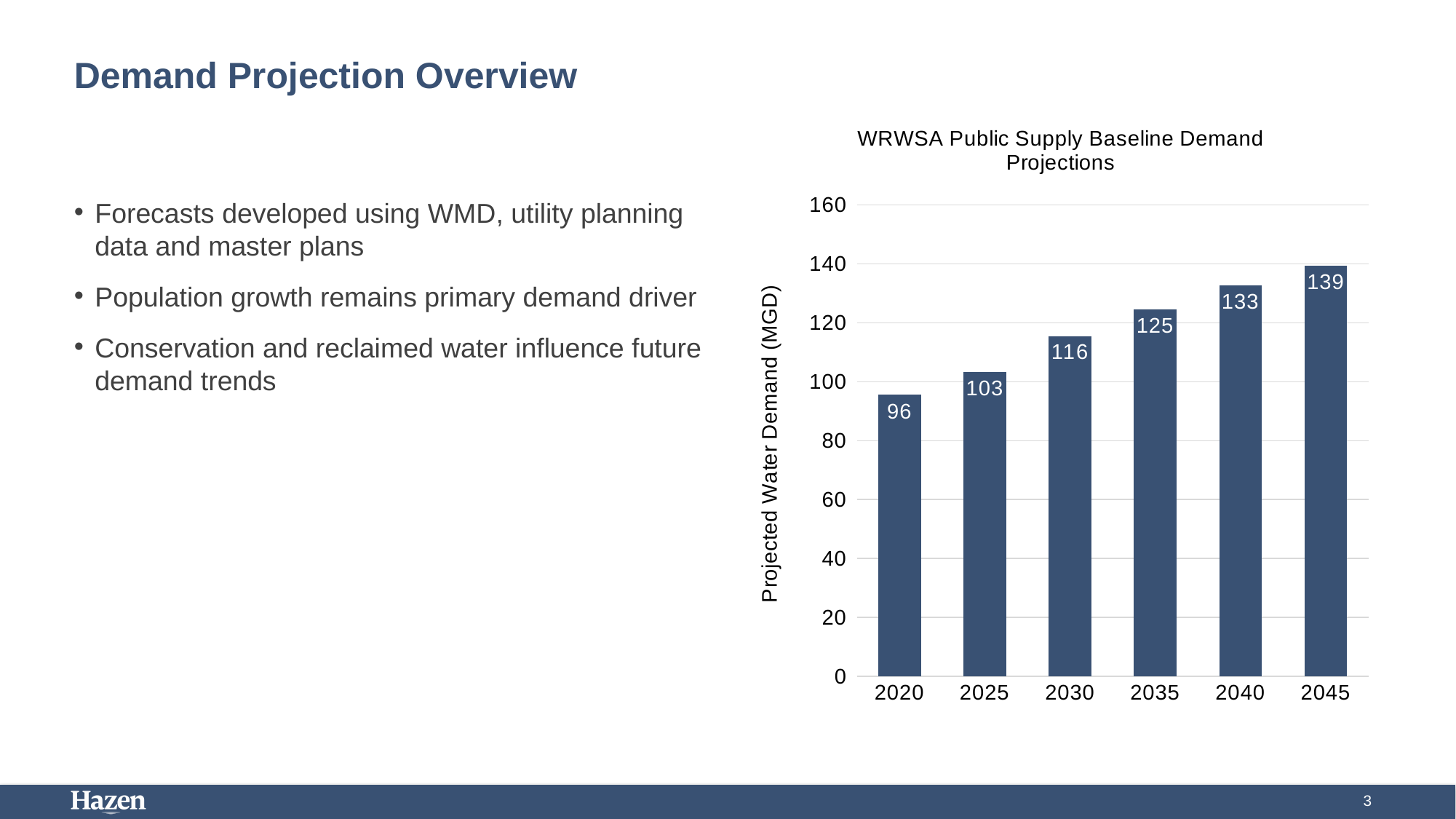
Is the projected water demand for 2035 greater or less than 120? greater What is the projected water demand for 2020? 96 Which year has a larger projected water demand, 2025 or 2040? 2040 Which year has the lowest projected water demand? 2020 Which year has the highest projected water demand? 2045 What is the difference in projected water demand between 2045 and 2020? 43 What is the difference in projected water demand between 2035 and 2025? 22 What is the projected water demand for 2030? 116 How many years are shown on the x axis of the chart? 6 What kind of chart is shown on the slide? Bar chart Does the projected water demand rise or fall from 2020 to 2045? Rise What is the projected water demand for 2045? 139